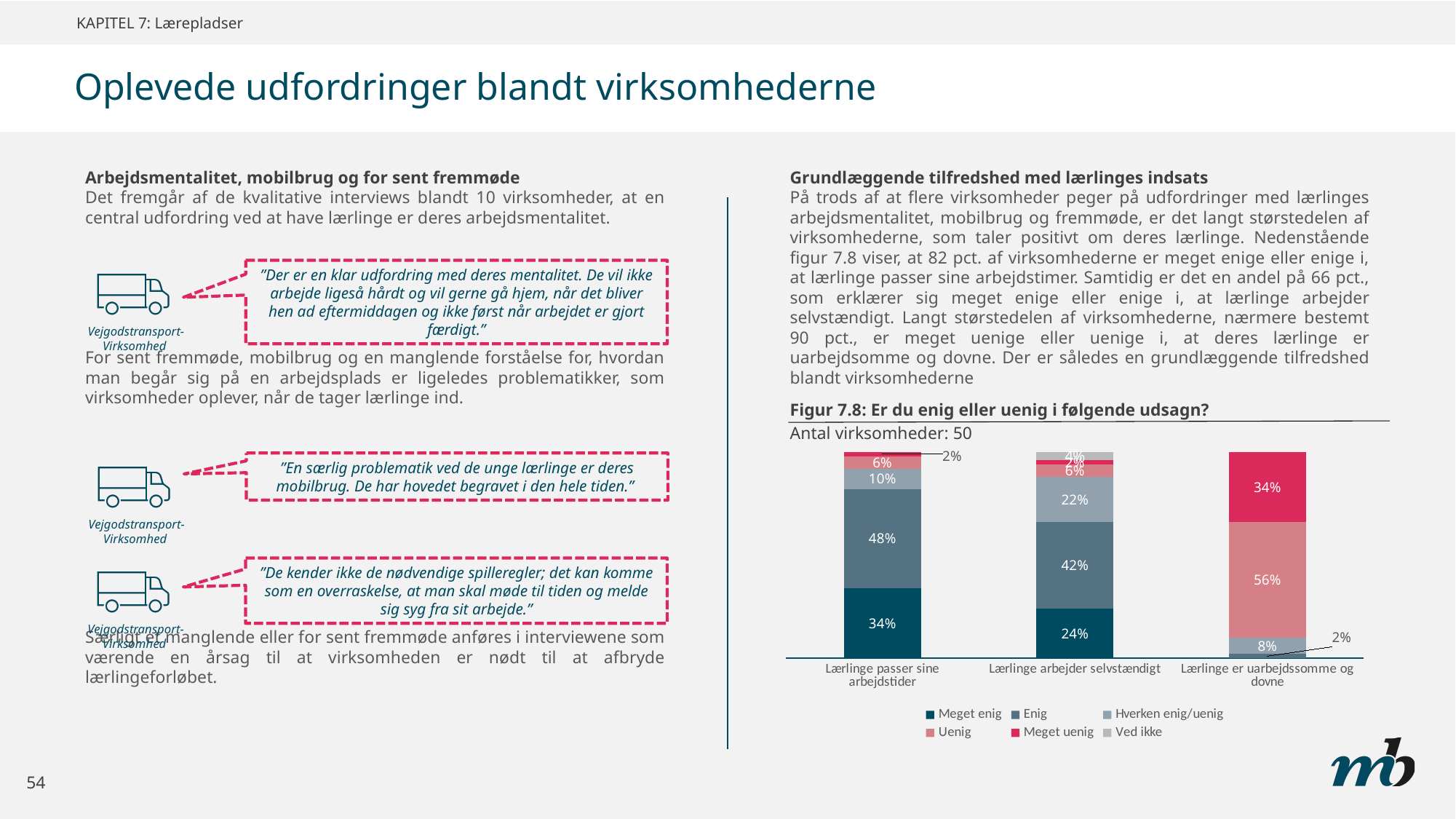
What kind of chart is shown in Figur 7.8? Stacked bar chart In Figur 7.8, what share of companies answered 'Meget uenig' to 'Lærlinge er uarbejdssomme og dovne'? 34% In Figur 7.8, what share of companies answered 'Uenig' to 'Lærlinge er uarbejdssomme og dovne'? 56% In Figur 7.8, what share of companies answered 'Hverken enig/uenig' to 'Lærlinge arbejder selvstændigt'? 22% In Figur 7.8, what share of companies answered 'Enig' to 'Lærlinge passer sine arbejdstider'? 48% How many companies (Antal virksomheder) does Figur 7.8 state were surveyed? 50 In Figur 7.8, what is the difference between the 'Enig' shares for 'Lærlinge passer sine arbejdstider' (48%) and 'Lærlinge arbejder selvstændigt' (42%)? 6 percentage points In Figur 7.8, what share of companies answered 'Meget enig' to 'Lærlinge passer sine arbejdstider'? 34% How many series does the legend of Figur 7.8 list? 6 How many statements (categories) are shown on the x axis of Figur 7.8? 3 In Figur 7.8, which statement has the larger 'Meget enig' share: 'Lærlinge passer sine arbejdstider' or 'Lærlinge arbejder selvstændigt'? Lærlinge passer sine arbejdstider In Figur 7.8, what is the combined share of 'Meget enig' and 'Enig' for 'Lærlinge passer sine arbejdstider'? 82%